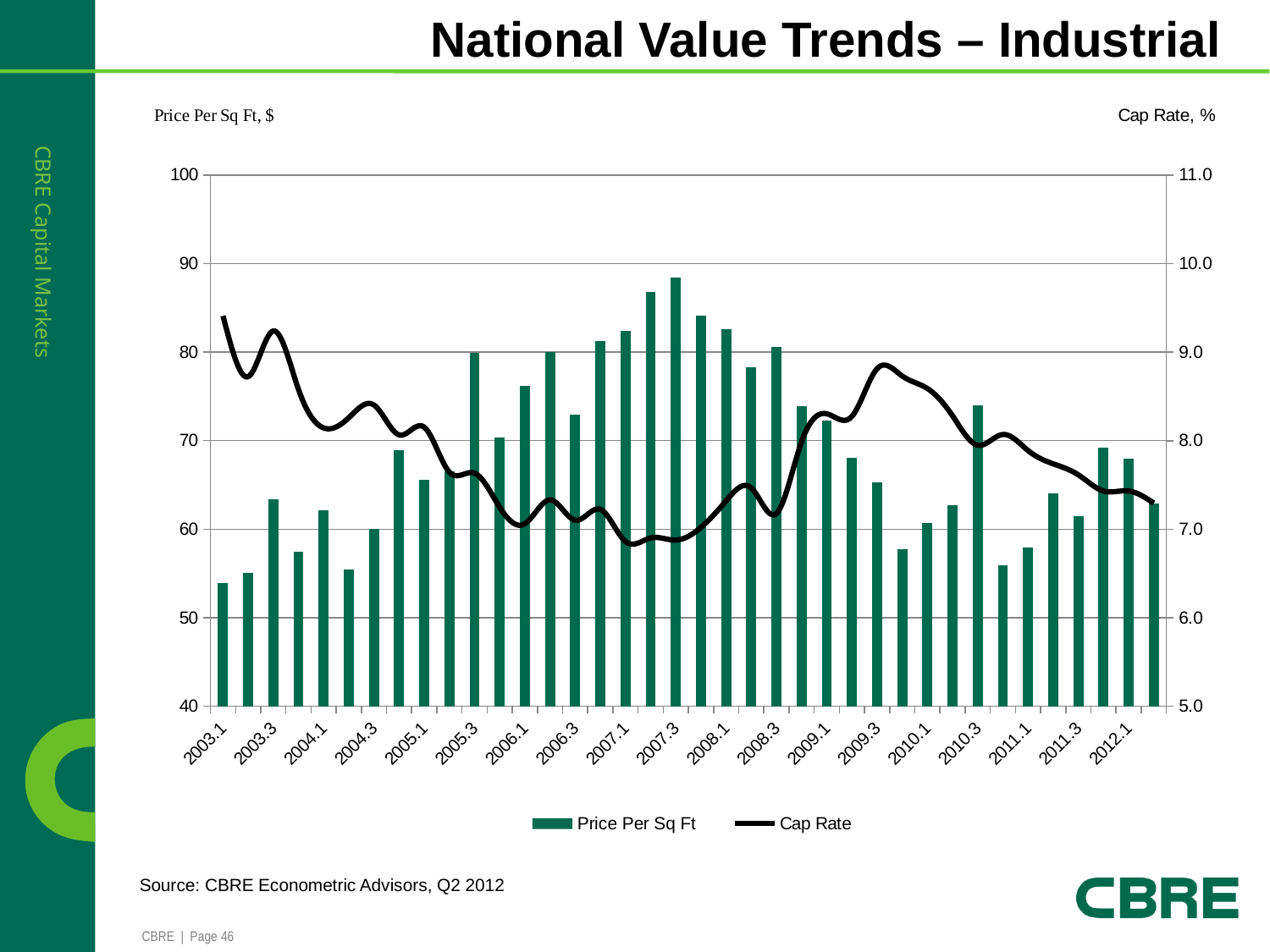
How many series does the legend list? 2 In which quarter is the Price Per Sq Ft bar the highest? 2007.3 Is the Price Per Sq Ft value for 2007.3 greater or less than 80? greater Is the Price Per Sq Ft value for 2003.1 greater or less than 60? less What kind of chart is shown on the slide? A combination bar and line chart What is the label of the right-hand vertical axis? Cap Rate, % Which has the larger Price Per Sq Ft value, 2008.1 or 2009.1? 2008.1 Does the Price Per Sq Ft series generally rise or fall from 2003.1 to 2007.3? rise Does the Cap Rate line rise or fall from 2009.3 to 2012.1? fall What are the two series named in the legend? Price Per Sq Ft and Cap Rate Is the Cap Rate value for 2003.1 greater or less than 9.0? greater